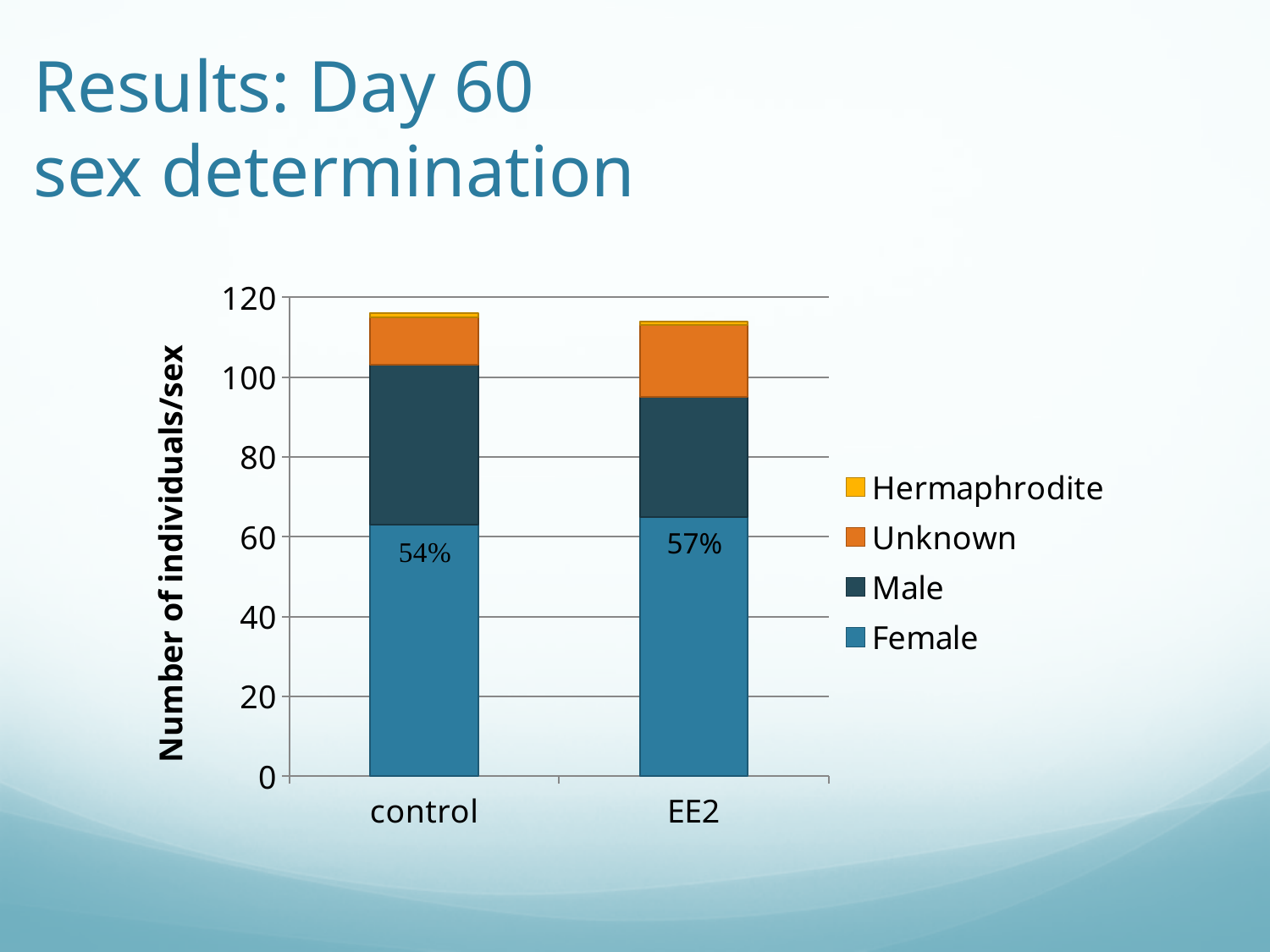
Is the total height of the EE2 bar greater or less than 100? greater Which bar has the higher Female percentage label, control or EE2? EE2 How many series does the legend list? 4 Is the Female value for EE2 greater or less than 60? greater Which series is plotted at the bottom of each stacked bar? Female What is the title of the y axis? Number of individuals/sex Is the total height of the control bar greater or less than 100? greater What percentage label is shown on the Female segment of the EE2 bar? 57% How many categories are shown on the x axis? 2 Which bar has the larger Unknown segment, control or EE2? EE2 What percentage label is shown on the Female segment of the control bar? 54% What kind of chart is shown on the slide? stacked bar chart